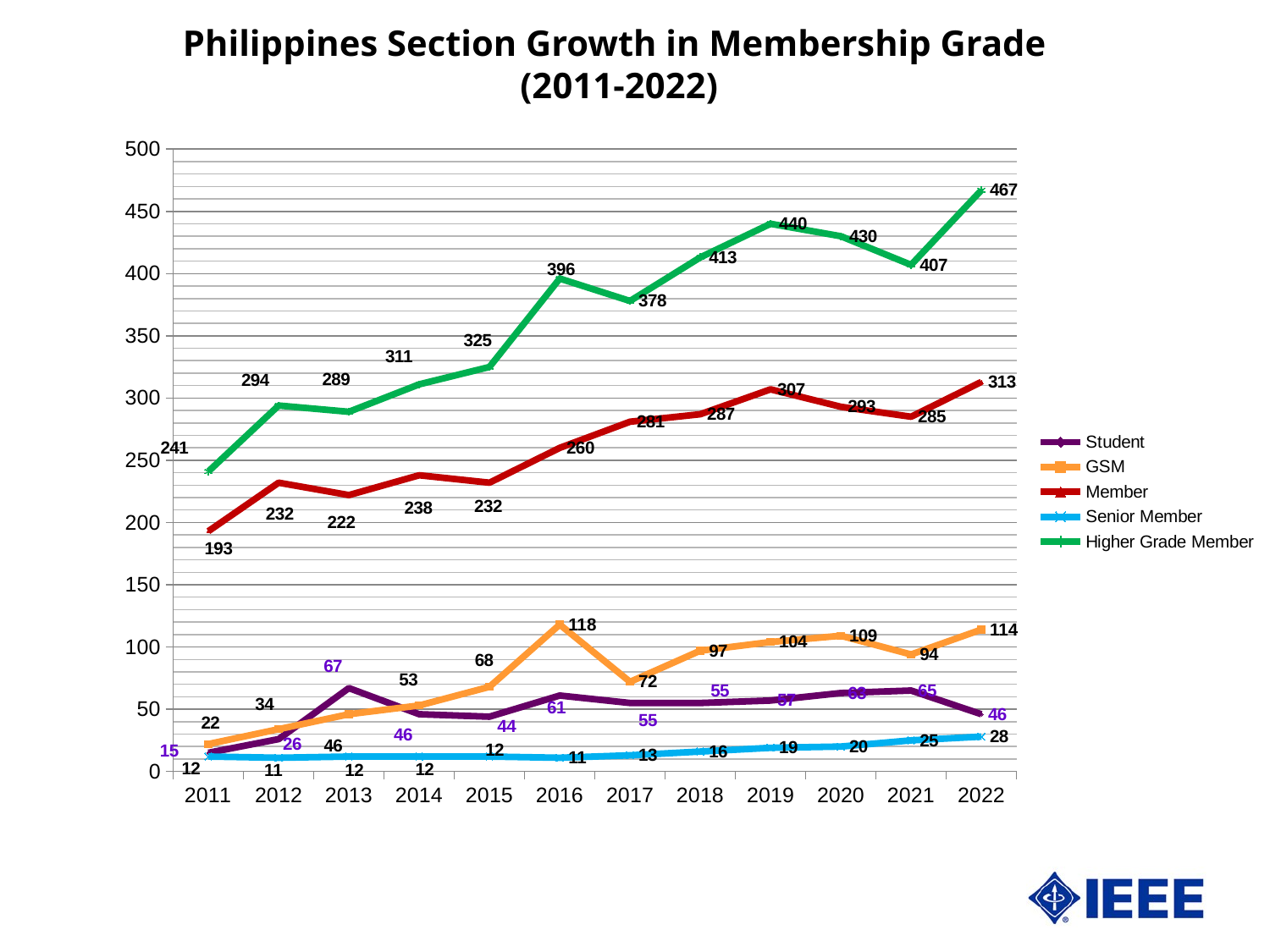
Which is larger in 2016, the GSM value or the Student value? GSM How many series does the legend list? 5 What kind of chart is shown on the slide? line chart What is the Member value for 2011? 193 In which year is the Member value lowest? 2011 By how much did the Higher Grade Member value increase from 2011 to 2022? 226 What is the Senior Member value for 2021? 25 In which year is the Higher Grade Member value highest? 2022 What is the Higher Grade Member value for 2022? 467 Do the Senior Member values rise or fall from 2018 to 2022? rise What is the GSM value for 2016? 118 How many years are plotted along the x axis? 12